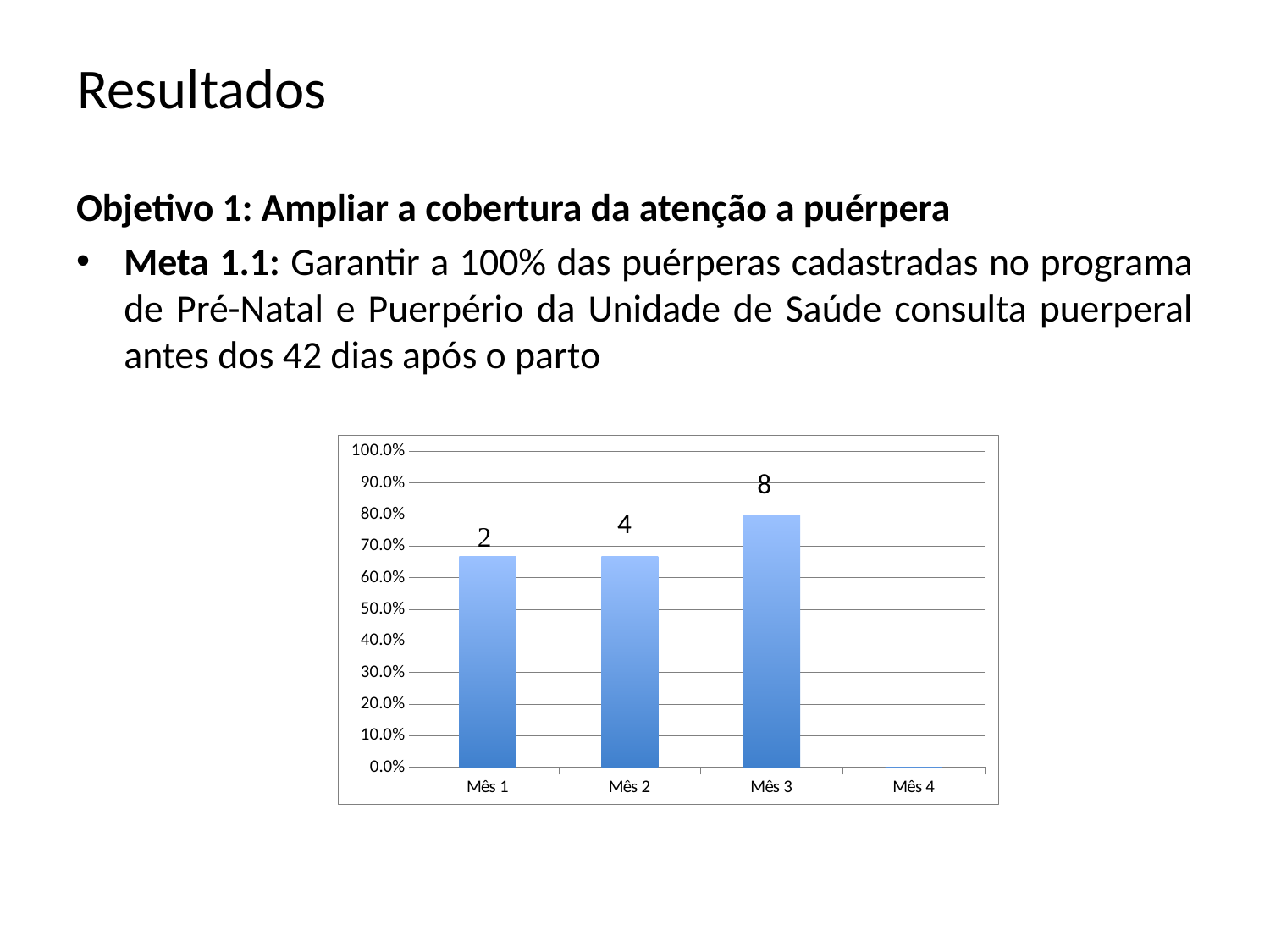
What data label is printed above the bar for Mês 3? 8 Is the bar for Mês 1 greater or less than 60.0%? greater Which bar is taller, Mês 3 or Mês 1? Mês 3 Which month has the tallest bar in the chart? Mês 3 What kind of chart is shown on the slide? bar chart Is the bar for Mês 4 greater or less than 10.0%? less Which month has the lowest bar in the chart? Mês 4 What data label is printed above the bar for Mês 2? 4 Is the bar for Mês 2 greater or less than 70.0%? less How many months (categories) are shown on the x axis of the chart? 4 What is the difference between the data labels printed for Mês 3 and Mês 2? 4 What data label is printed above the bar for Mês 1? 2